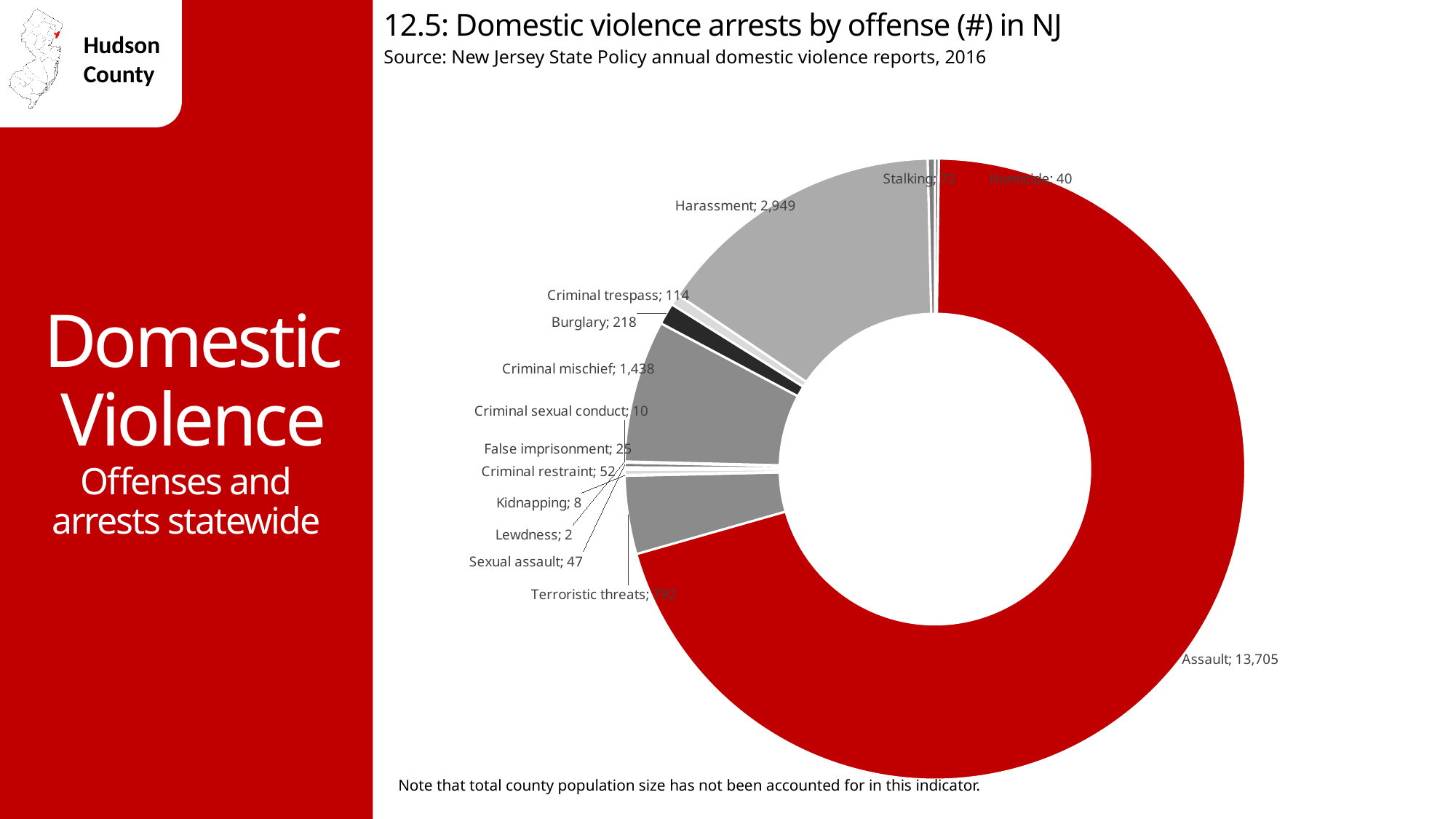
What is the value for Burglary? 218 What type of chart is shown on the slide? Pie (donut) chart Which is larger, the value for Burglary or the value for Criminal trespass? Burglary Which offense has the lowest number of arrests? Lewdness What is the value for Harassment? 2,949 How many domestic violence arrests for Assault are shown? 13,705 What is the title of the chart? 12.5: Domestic violence arrests by offense (#) in NJ What is the value for Homicide? 40 Which offense has the highest number of arrests? Assault What is the value for Criminal trespass? 114 What is the difference between the Harassment and Criminal mischief values? 1,511 What is the value for Criminal mischief? 1,438